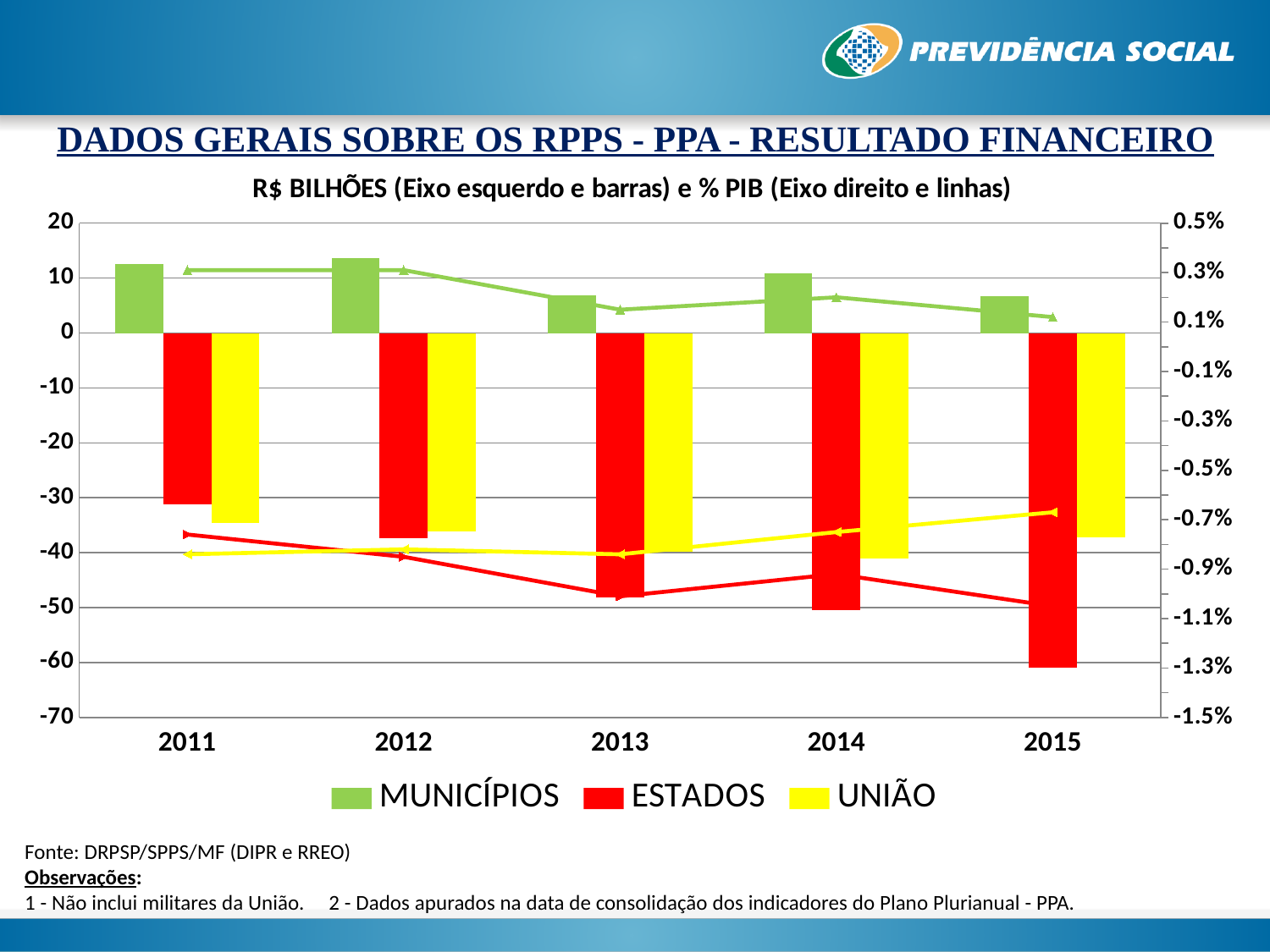
In 2011, which bar has the larger value, ESTADOS or UNIÃO? ESTADOS Which colour represents the UNIÃO series in the chart? yellow Is the UNIÃO bar value for 2011 greater or less than -40? greater What kind of chart is shown on the slide? combined bar and line chart Is the MUNICÍPIOS bar value for 2011 greater or less than 10? greater Do the ESTADOS bar values rise or fall from 2011 to 2015? fall How many years are shown on the x axis of the chart? 5 In which year is the ESTADOS bar the lowest (most negative)? 2015 How many series does the chart legend list? 3 Is the ESTADOS bar value for 2013 greater or less than -40? less In which year is the ESTADOS bar the highest (least negative)? 2011 In 2015, which bar has the larger value, ESTADOS or UNIÃO? UNIÃO